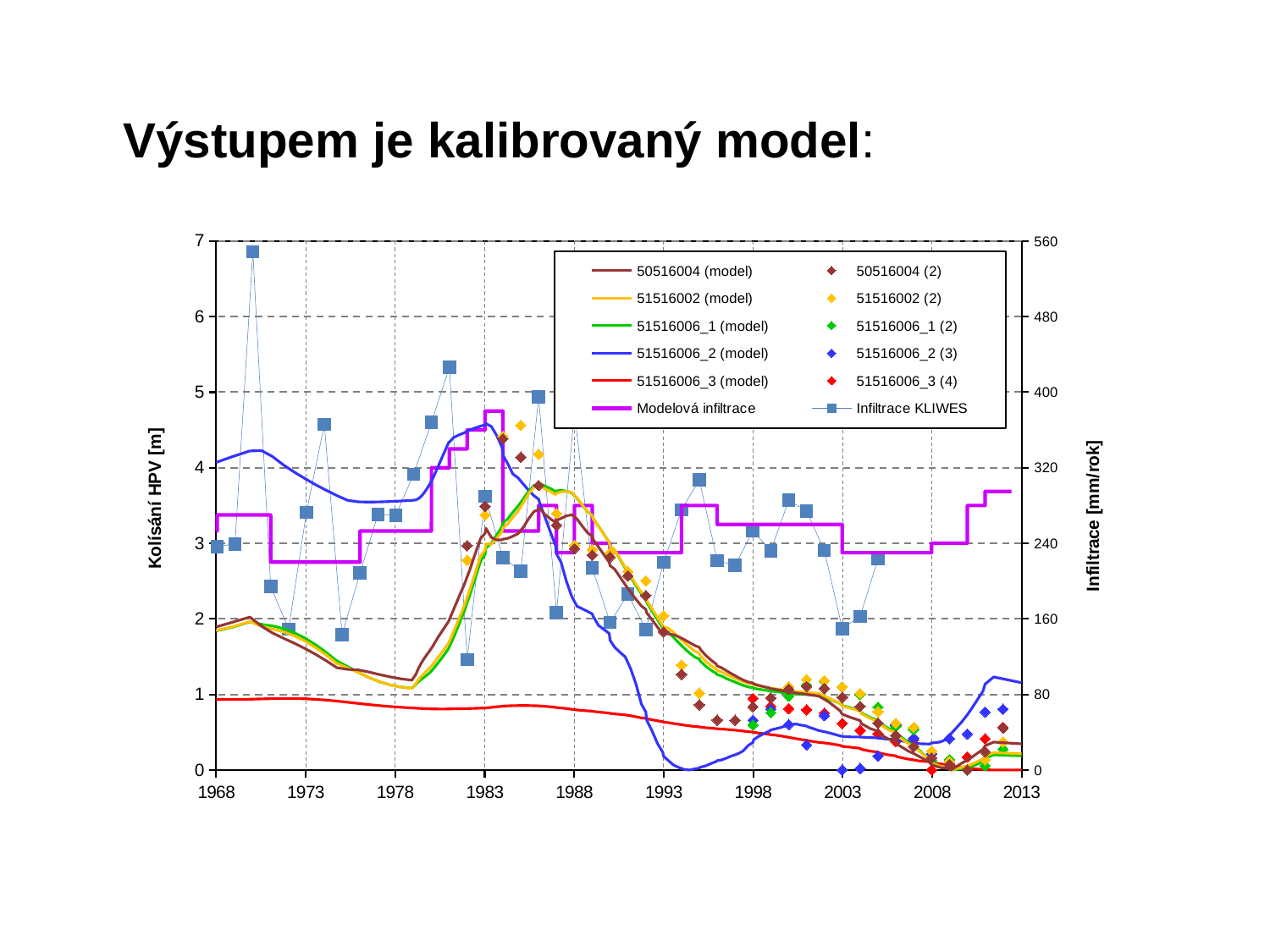
How many series does the chart legend list? 12 In 1975, which is larger: 51516006_2 (model) or 51516006_3 (model)? 51516006_2 (model) Is the value for Infiltrace KLIWES in 1969 greater or less than 480? less Is the value for 51516006_3 (model) in 1983 greater or less than 1? less What is the label of the left vertical axis? Kolísání HPV [m] What is the label of the right vertical axis? Infiltrace [mm/rok] What kind of chart is shown on the slide? line chart Is the value for 51516006_2 (model) in 1995 greater or less than 1? less What is the first year shown on the x axis? 1968 What is the last year shown on the x axis? 2013 Does the 51516006_2 (model) line rise or fall between 1988 and 1995? fall